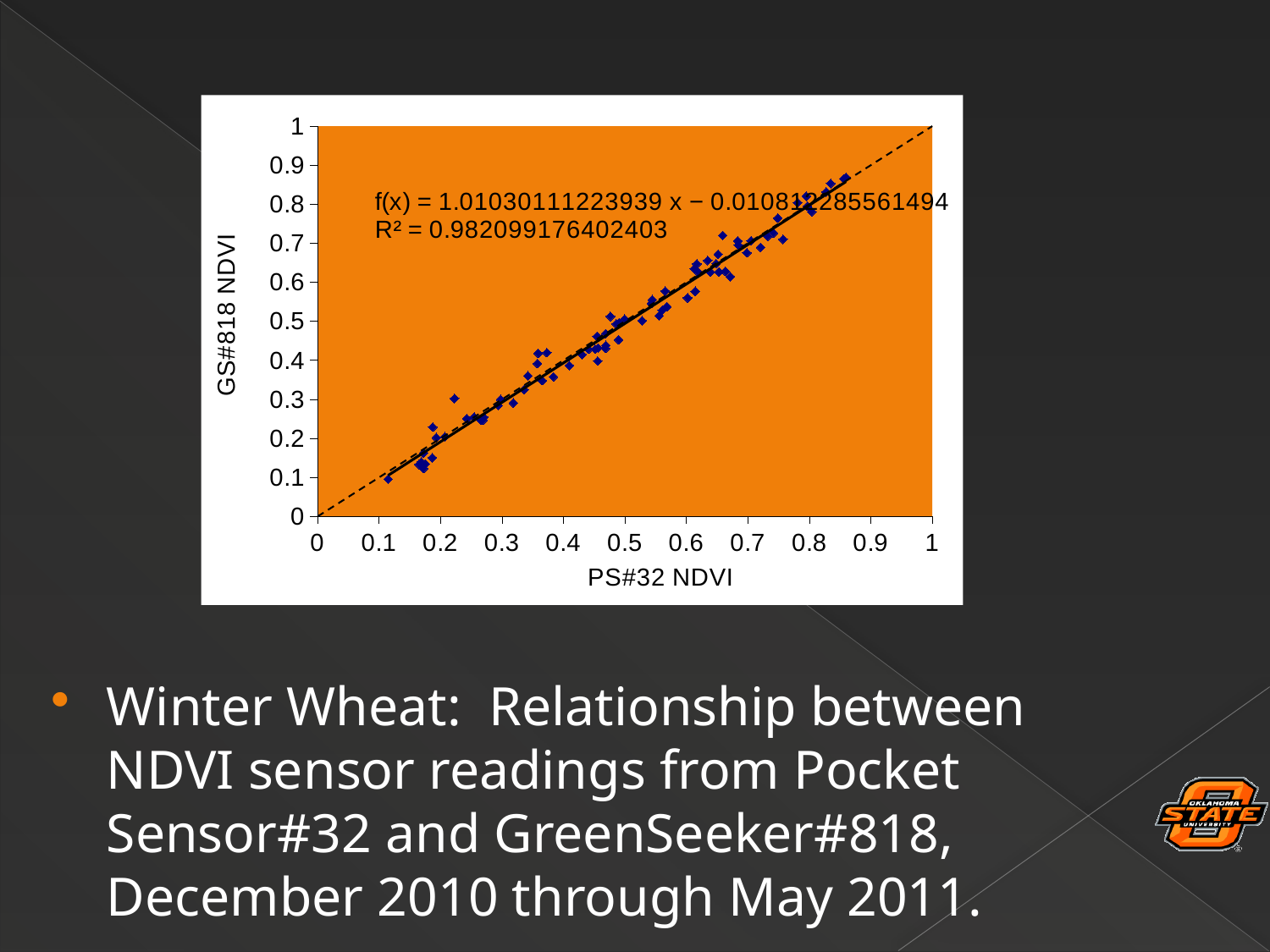
What is the interval between consecutive tick marks on the x axis? 0.1 Do any plotted points reach a GS#818 NDVI value of 0.9 or above? No What is the label of the y axis? GS#818 NDVI What kind of chart is shown on the slide? scatter chart What is the slope (coefficient of x) in the fitted equation f(x) printed on the chart? 1.01030111223939 What is the label of the x axis? PS#32 NDVI As PS#32 NDVI increases along the x axis, do the GS#818 NDVI values rise or fall? rise What is the highest tick value shown on the y axis? 1 What is the R² value printed on the chart? 0.982099176402403 Is the GS#818 NDVI value of the lowest plotted point greater or less than 0.2? less Is the GS#818 NDVI value of the highest plotted point greater or less than 0.8? greater